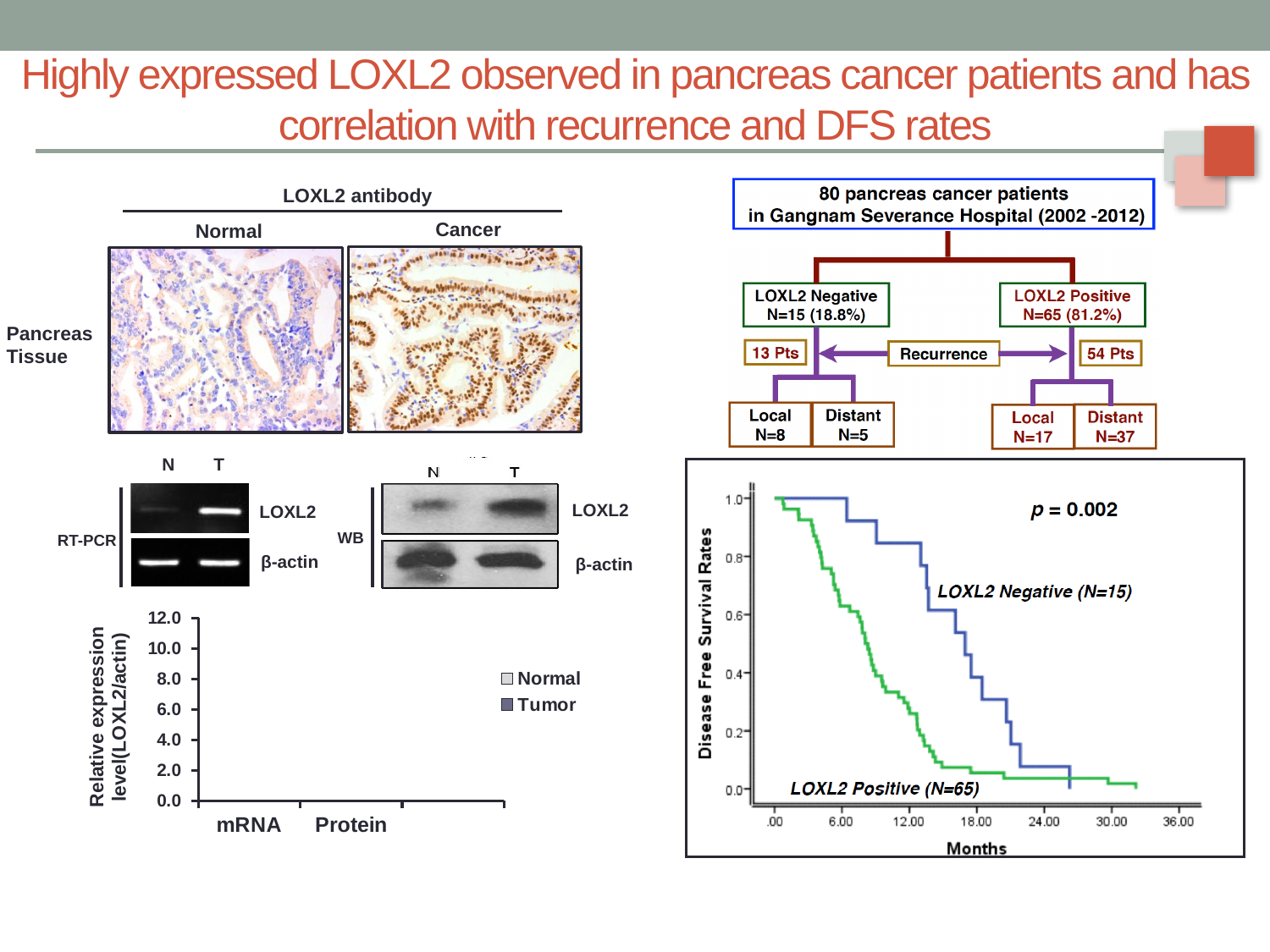
In the survival chart at the bottom right, which group has the higher disease free survival rate at 12 months, LOXL2 Negative or LOXL2 Positive? LOXL2 Negative In the survival chart at the bottom right, is the disease free survival rate for LOXL2 Positive at 12 months greater or less than 0.4? less In the survival chart at the bottom right, what p value is printed? p = 0.002 In the bar chart at the bottom left, what is the highest value shown on the y axis? 12.0 In the survival chart at the bottom right, what is the x-axis title? Months In the bar chart at the bottom left, what are the two legend entries? Normal and Tumor In the bar chart at the bottom left, how many series does the legend list? 2 In the bar chart at the bottom left, how many categories are shown on the x axis? 2 In the survival chart at the bottom right, how many patients are in the LOXL2 Positive group? 65 In the survival chart at the bottom right, how many patients are in the LOXL2 Negative group? 15 In the bar chart at the bottom left, what is the y-axis title? Relative expression level(LOXL2/actin) In the survival chart at the bottom right, do the disease free survival rates rise or fall as months increase? fall